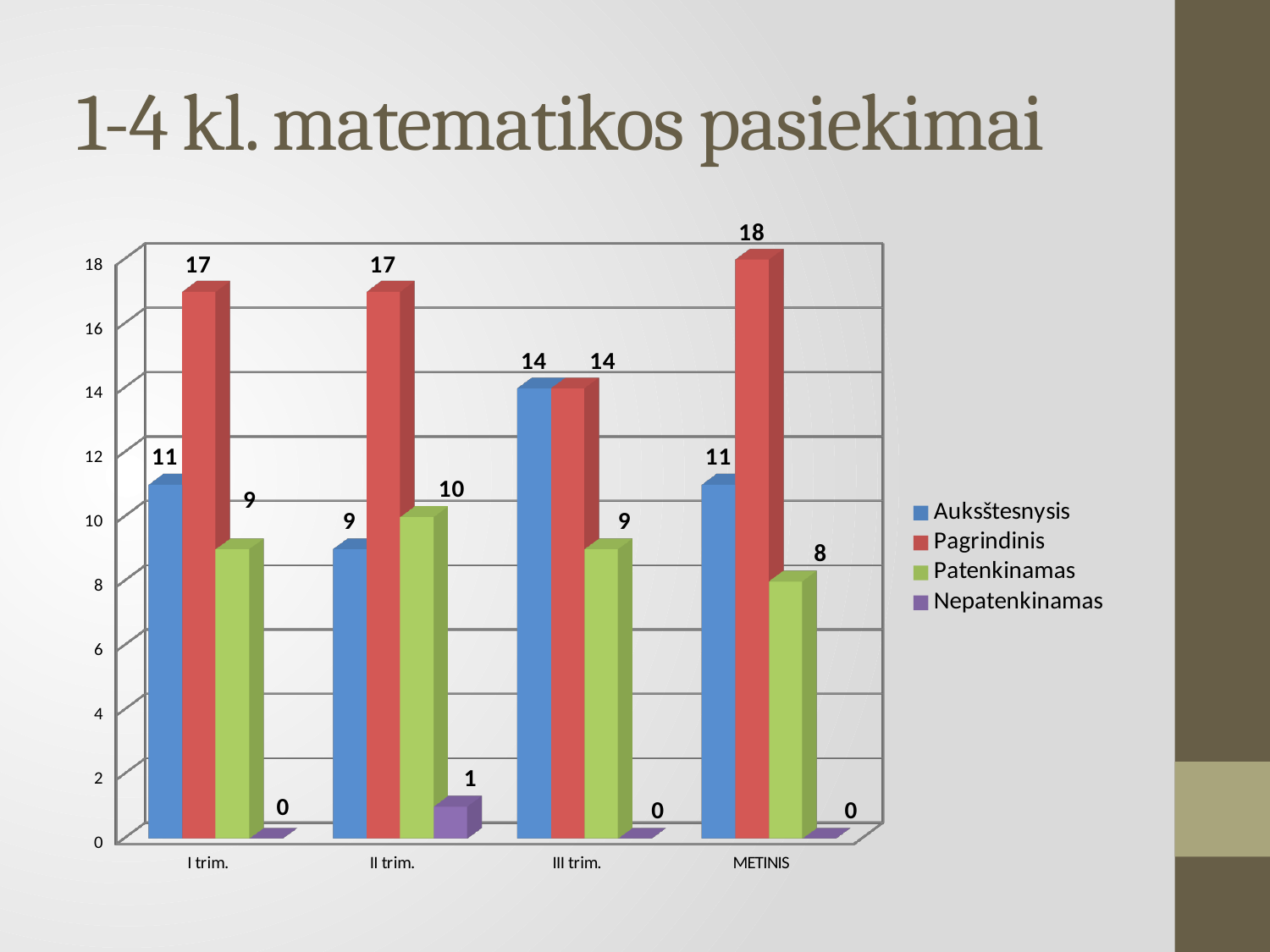
How many series does the legend list? 4 What is the value for Pagrindinis in METINIS? 18 What is the title of the slide? 1-4 kl. matematikos pasiekimai What kind of chart is shown on the slide? bar chart What is the difference between the Pagrindinis and Auksštesnysis values in I trim.? 6 In which category is the Auksštesnysis value lowest? II trim. What is the value for Auksštesnysis in III trim.? 14 What is the value for Patenkinamas in II trim.? 10 What is the value for Nepatenkinamas in II trim.? 1 How many categories are shown on the x axis? 4 In which category is the Pagrindinis value highest? METINIS Which is larger in METINIS: Auksštesnysis or Patenkinamas? Auksštesnysis